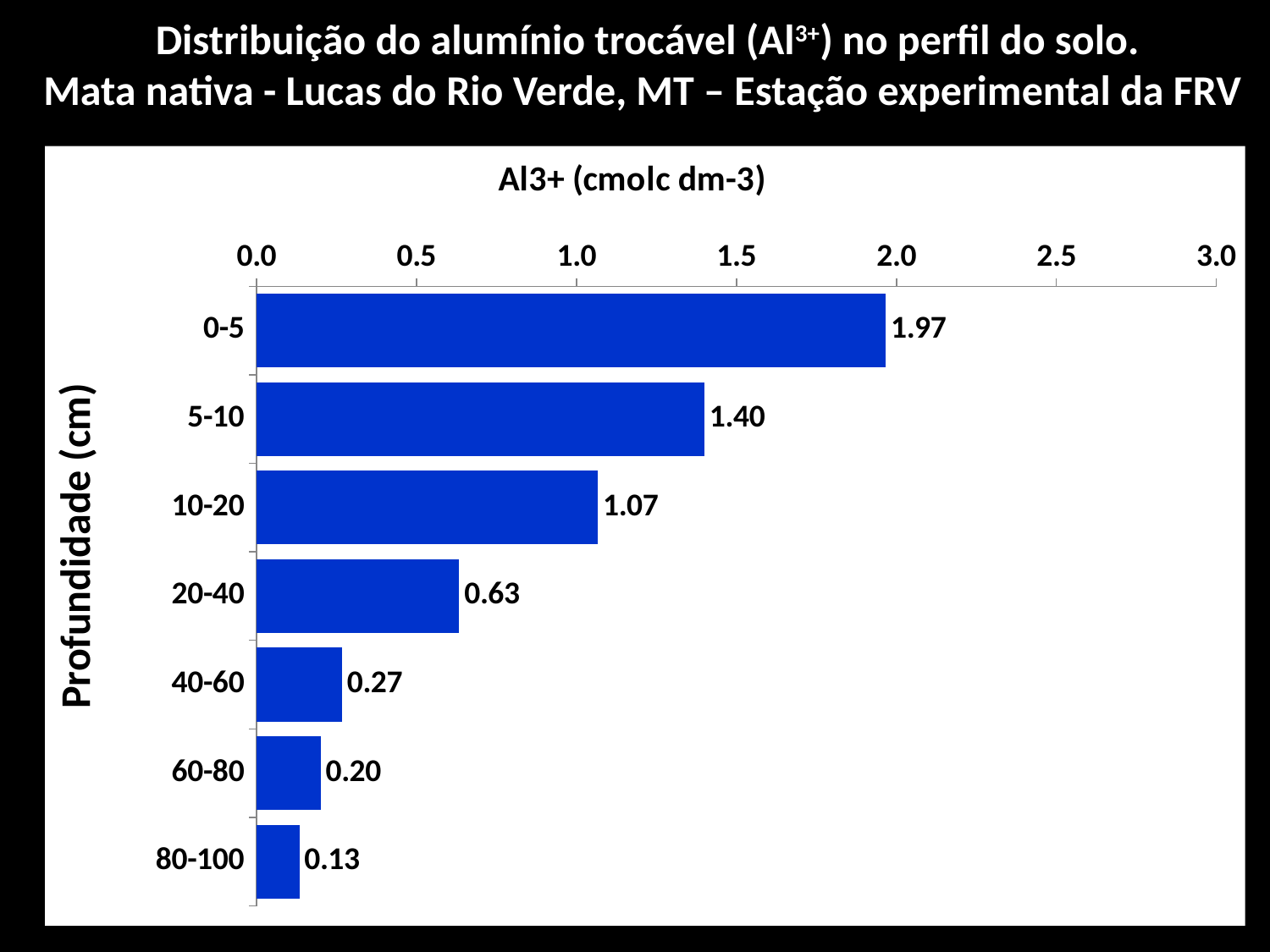
Which depth has the highest Al3+ value? 0-5 What is the label of the vertical axis? Profundidade (cm) Which has a larger Al3+ value, 40-60 cm or 60-80 cm? 40-60 Is the Al3+ value for 10-20 cm greater or less than 1.0? greater How many depth categories are shown in the chart? 7 What is the difference between the Al3+ values for 10-20 cm and 20-40 cm? 0.44 What is the Al3+ value for the 80-100 cm depth? 0.13 What is the Al3+ value for the 20-40 cm depth? 0.63 What is the Al3+ value for the 0-5 cm depth? 1.97 What kind of chart is shown on the slide? bar chart Which depth has the lowest Al3+ value? 80-100 What is the difference between the Al3+ values for 0-5 cm and 5-10 cm? 0.57